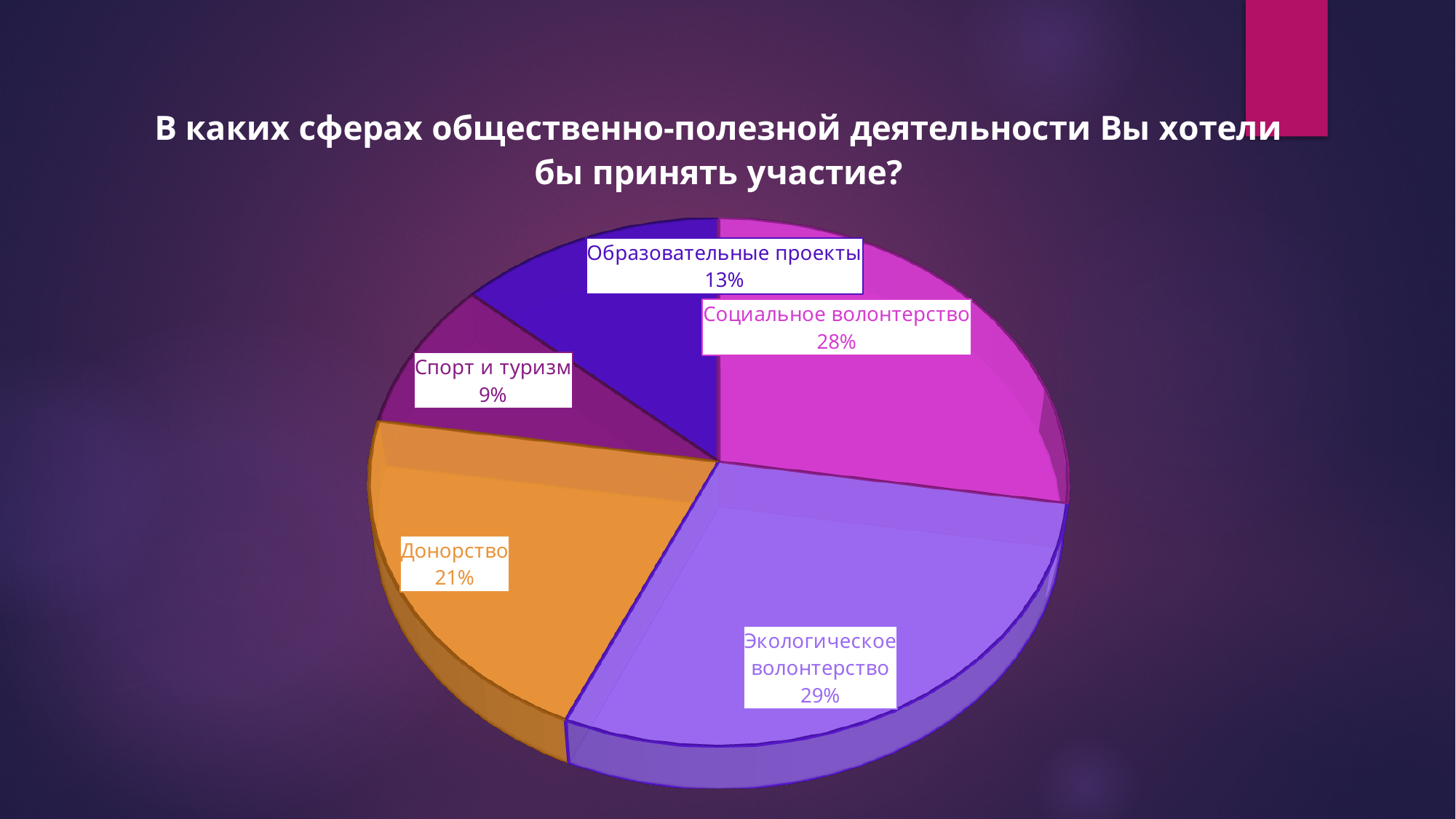
Which category has the largest share of the pie? Экологическое волонтерство Which is larger, the share for Донорство or the share for Образовательные проекты? Донорство What is the value shown for Социальное волонтерство? 28% What is the difference in percentage points between Социальное волонтерство and Донорство? 7 Which category has the smallest share of the pie? Спорт и туризм What is the value shown for Образовательные проекты? 13% What kind of chart is shown on the slide? Pie chart What is the value shown for Спорт и туризм? 9% What is the value shown for Донорство? 21% What is the title of the chart on the slide? В каких сферах общественно-полезной деятельности Вы хотели бы принять участие? How many categories (slices) does the pie chart have? 5 What share of the pie does Экологическое волонтерство have? 29%